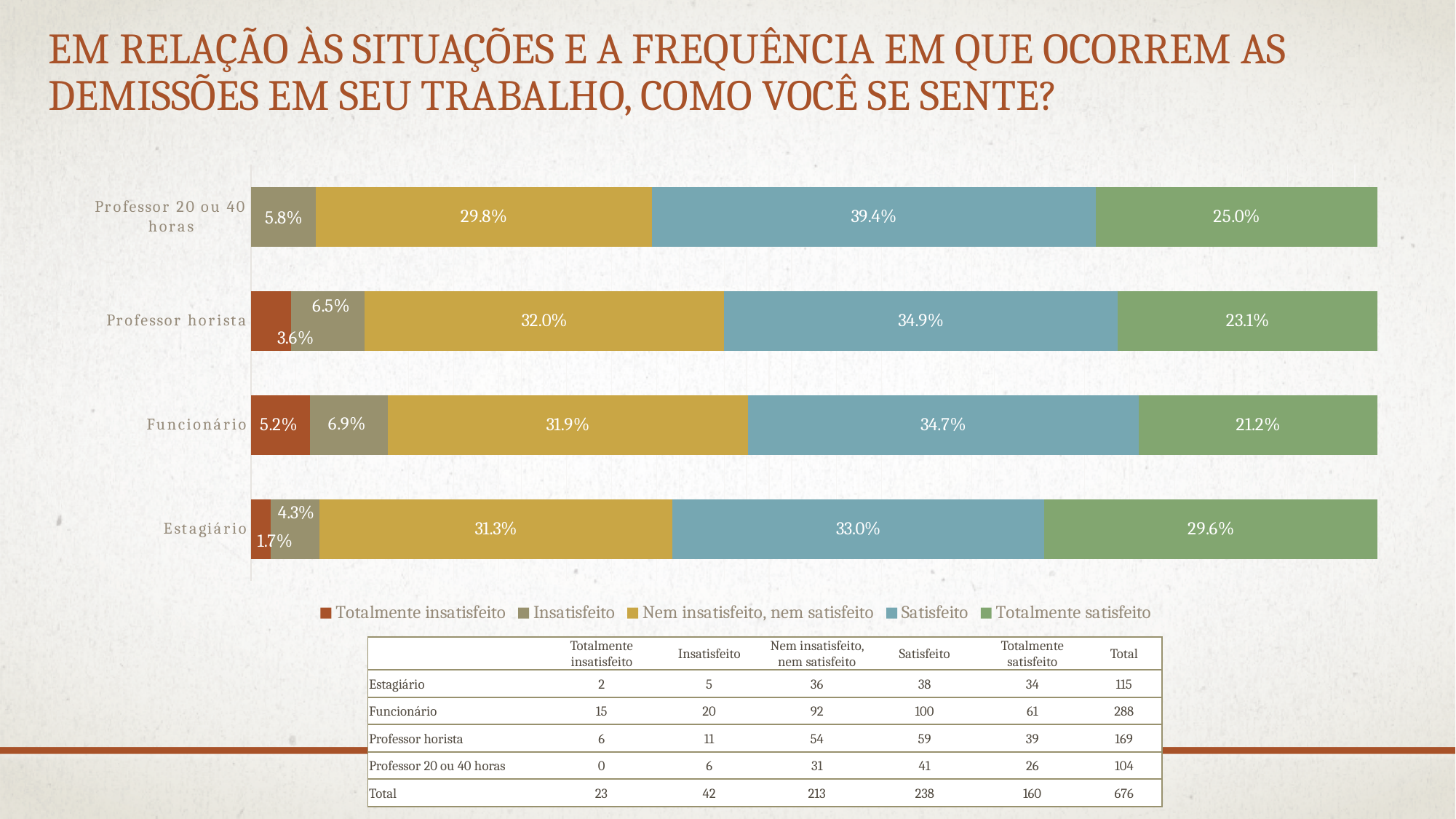
What is the Nem insatisfeito, nem satisfeito value for Professor horista? 32.0% What is the Totalmente satisfeito value for Estagiário? 29.6% What percentage of Professor 20 ou 40 horas respondents answered Satisfeito? 39.4% What kind of chart is shown on the slide? Stacked bar chart Which category has the highest Satisfeito percentage? Professor 20 ou 40 horas Which response has the largest share within the Estagiário bar? Satisfeito How many series does the legend list? 5 Which is larger: the Insatisfeito value for Funcionário or for Professor horista? Funcionário Which category has the lowest Totalmente satisfeito percentage? Funcionário What is the difference in percentage points between the Totalmente satisfeito values for Estagiário and Funcionário? 8.4 percentage points How many categories (job types) are shown in the chart? 4 What is the Totalmente insatisfeito value for Funcionário? 5.2%